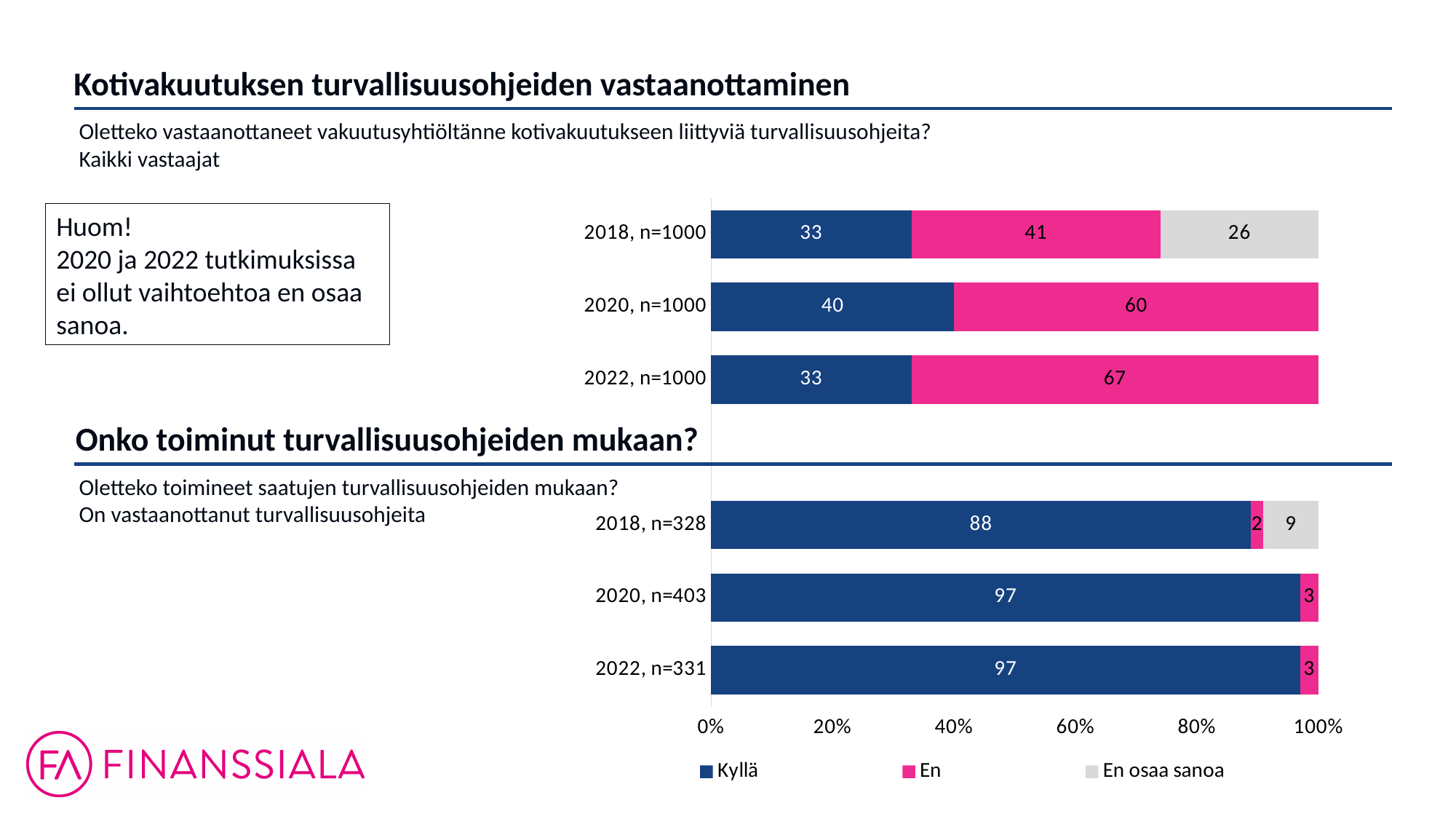
In the chart 'Onko toiminut turvallisuusohjeiden mukaan?', what is the En osaa sanoa value for 2018, n=328? 9 In the chart 'Onko toiminut turvallisuusohjeiden mukaan?', what is the Kyllä value for 2018, n=328? 88 In the chart 'Kotivakuutuksen turvallisuusohjeiden vastaanottaminen', what is the En value for 2022, n=1000? 67 What kind of chart is used on the slide? Stacked bar chart In the chart 'Kotivakuutuksen turvallisuusohjeiden vastaanottaminen', what is the Kyllä value for 2018, n=1000? 33 In the chart 'Kotivakuutuksen turvallisuusohjeiden vastaanottaminen', what is the En osaa sanoa value for 2018, n=1000? 26 In the chart 'Onko toiminut turvallisuusohjeiden mukaan?', is the Kyllä value for 2020, n=403 larger or smaller than the Kyllä value for 2018, n=328? larger In the chart 'Kotivakuutuksen turvallisuusohjeiden vastaanottaminen', what is the difference between the En values for 2022 and 2018? 26 In the chart 'Kotivakuutuksen turvallisuusohjeiden vastaanottaminen', which year has the highest Kyllä value? 2020, n=1000 How many series does the legend list? 3 In the chart 'Onko toiminut turvallisuusohjeiden mukaan?', what is the total of the stacked bar for 2018, n=328? 99 In the chart 'Onko toiminut turvallisuusohjeiden mukaan?', which year has the lowest Kyllä value? 2018, n=328